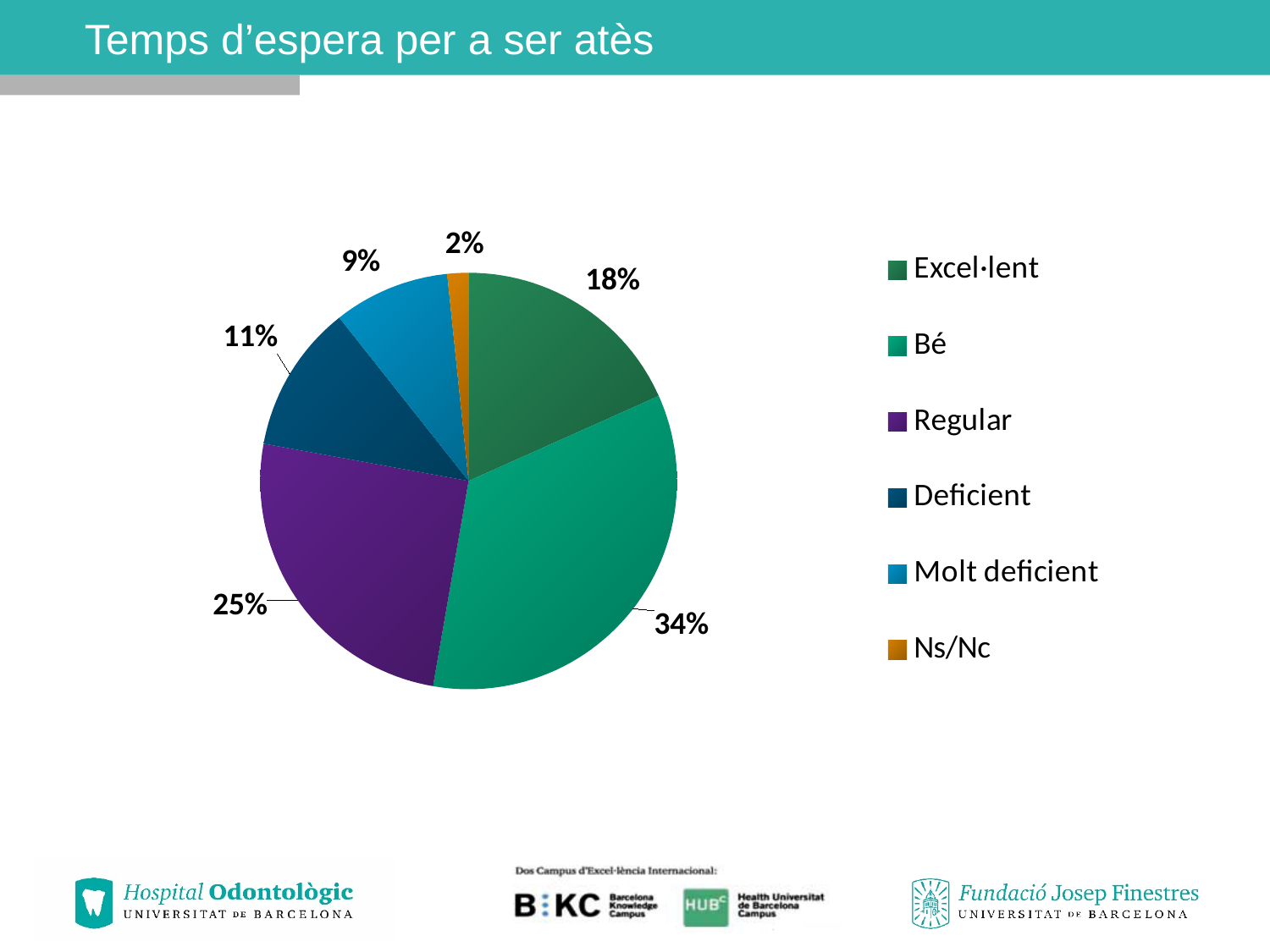
What percentage of the pie is labelled Ns/Nc? 2% What is the title of the slide containing the chart? Temps d’espera per a ser atès Which category has the largest share of the pie? Bé What percentage of the pie is labelled Bé? 34% What kind of chart is shown on the slide? pie chart What percentage of the pie is labelled Excel·lent? 18% Which category has the smallest share of the pie? Ns/Nc Which is larger, the share for Excel·lent or the share for Molt deficient? Excel·lent What is the difference in percentage points between Bé and Regular? 9 How many categories does the legend list? 6 What percentage of the pie is labelled Regular? 25% What percentage of the pie is labelled Deficient? 11%